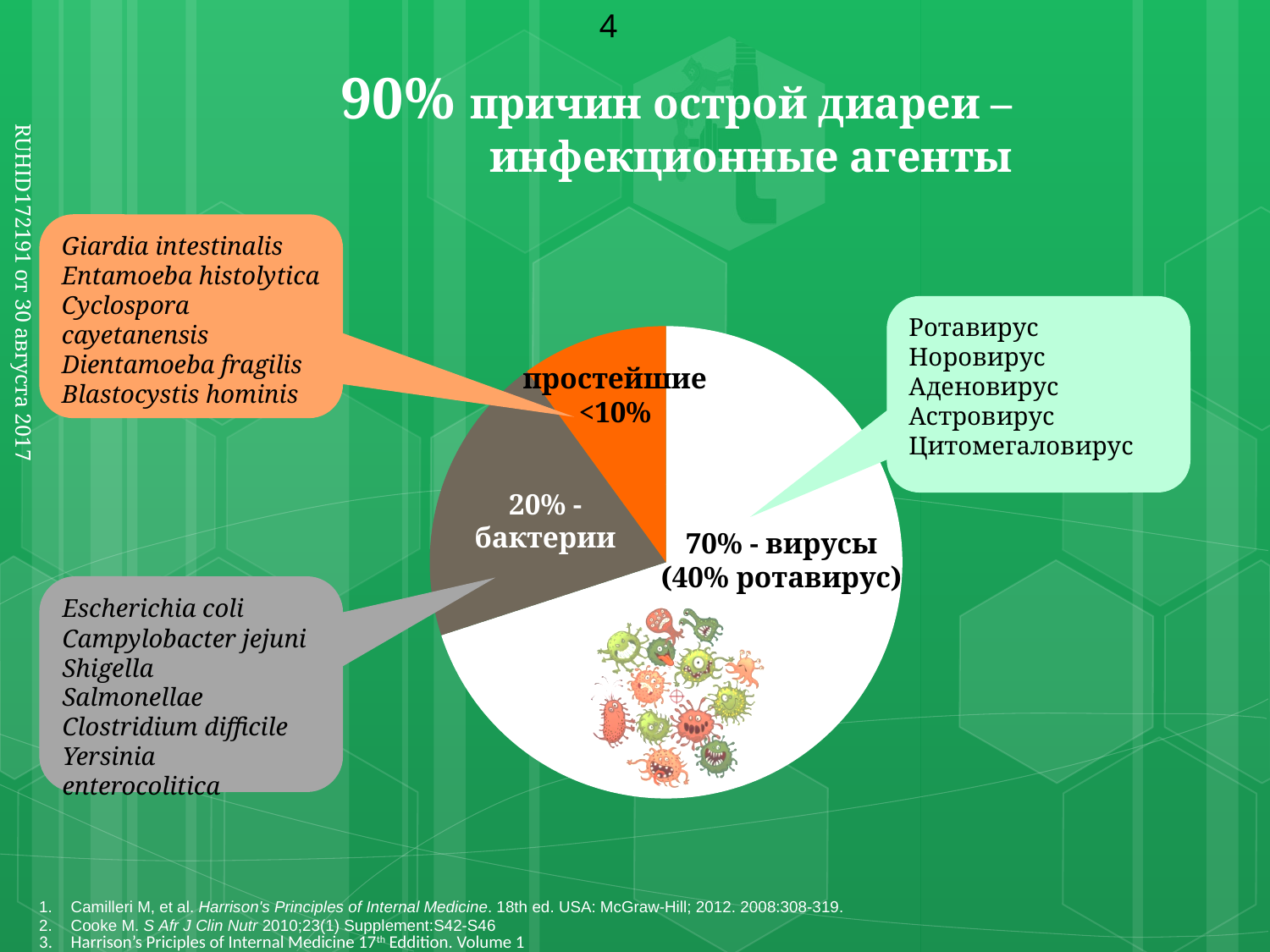
Which category has the largest slice of the pie chart? вирусы What colour is the простейшие slice of the pie chart? orange Which category has the smallest slice of the pie chart? простейшие What percentage of the pie chart is attributed to бактерии (bacteria)? 20% What colour is the вирусы slice of the pie chart? white What share of the viruses slice is attributed to ротавирус (rotavirus), according to the label? 40% How many slices does the pie chart have? 3 What kind of chart is shown on the slide? pie chart What percentage of the pie chart is attributed to вирусы (viruses)? 70% Which slice is larger: бактерии or простейшие? бактерии What value is printed for простейшие (protozoa) in the pie chart? <10% What is the difference in percentage points between the вирусы slice and the бактерии slice? 50%